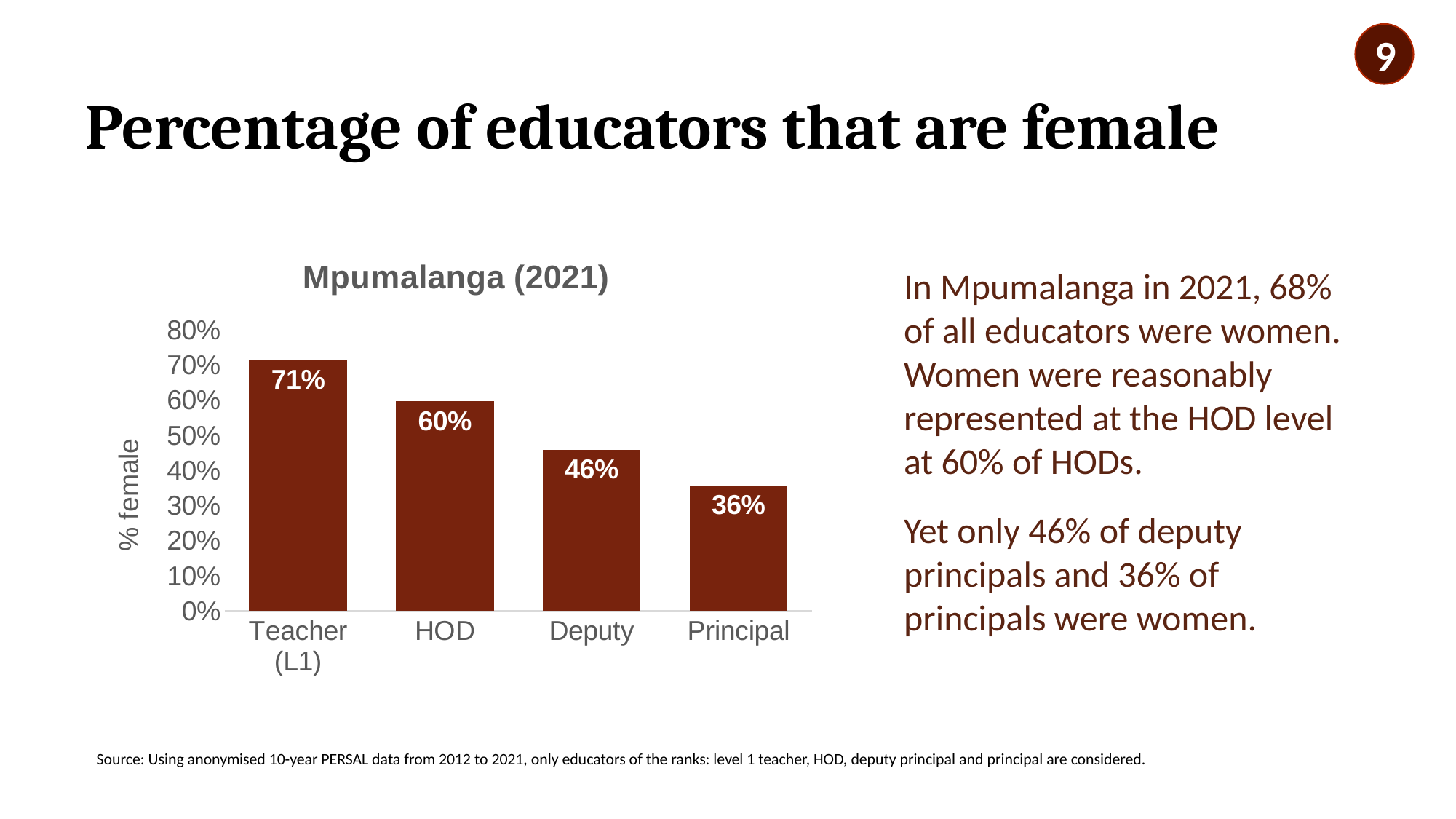
What is the difference between the Teacher (L1) value and the Principal value? 35% What is the value shown for HOD in the chart? 60% What kind of chart is shown on the slide? Bar chart Which is larger, the value for HOD or the value for Deputy? HOD What is the difference between the HOD value and the Deputy value? 14% What percentage of Teacher (L1) educators are female in the Mpumalanga (2021) chart? 71% Which category has the highest percentage of female educators? Teacher (L1) Do the values rise or fall moving from Teacher (L1) to Principal along the x axis? Fall What is the value shown for Deputy in the chart? 46% What is the value shown for Principal in the chart? 36% How many categories are shown on the x axis of the chart? 4 Which category has the lowest percentage of female educators? Principal